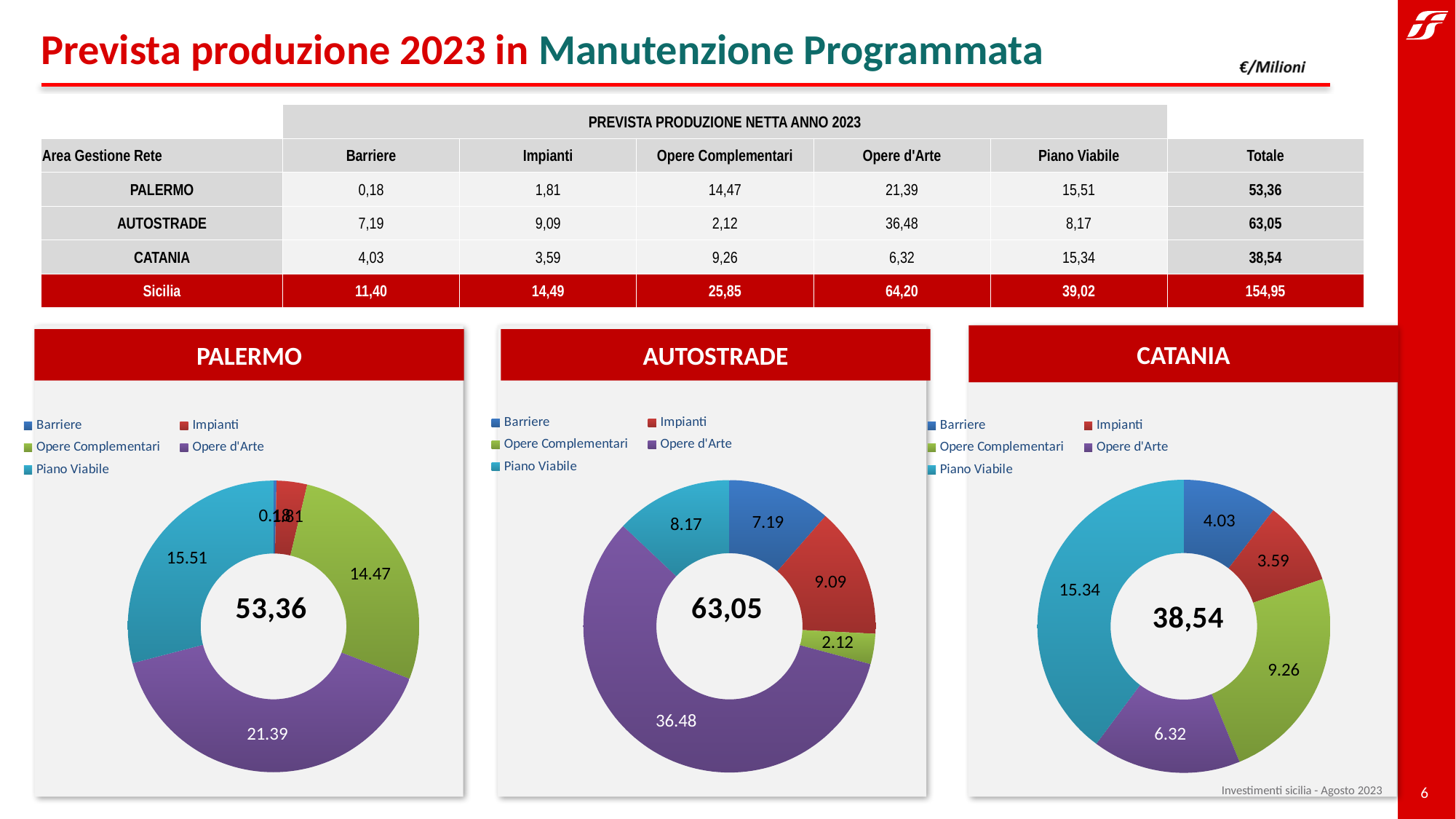
In the AUTOSTRADE chart, which category has the largest slice? Opere d'Arte In the PALERMO chart, which category has the largest slice? Opere d'Arte In the CATANIA chart, what is the difference between Piano Viabile and Opere Complementari? 6.08 In the AUTOSTRADE chart, which is larger, Barriere or Piano Viabile? Piano Viabile How many series does the legend of the PALERMO chart list? 5 In the AUTOSTRADE chart, what is the difference between Opere d'Arte and Opere Complementari? 34.36 In the AUTOSTRADE chart, what is the value for Impianti? 9.09 In the CATANIA chart, which category has the smallest slice? Impianti In the PALERMO chart, what is the value for Opere d'Arte? 21.39 In the CATANIA chart, what is the value for Piano Viabile? 15.34 What kind of chart is the CATANIA chart? Donut (pie) chart What total is shown in the centre of the AUTOSTRADE chart? 63,05